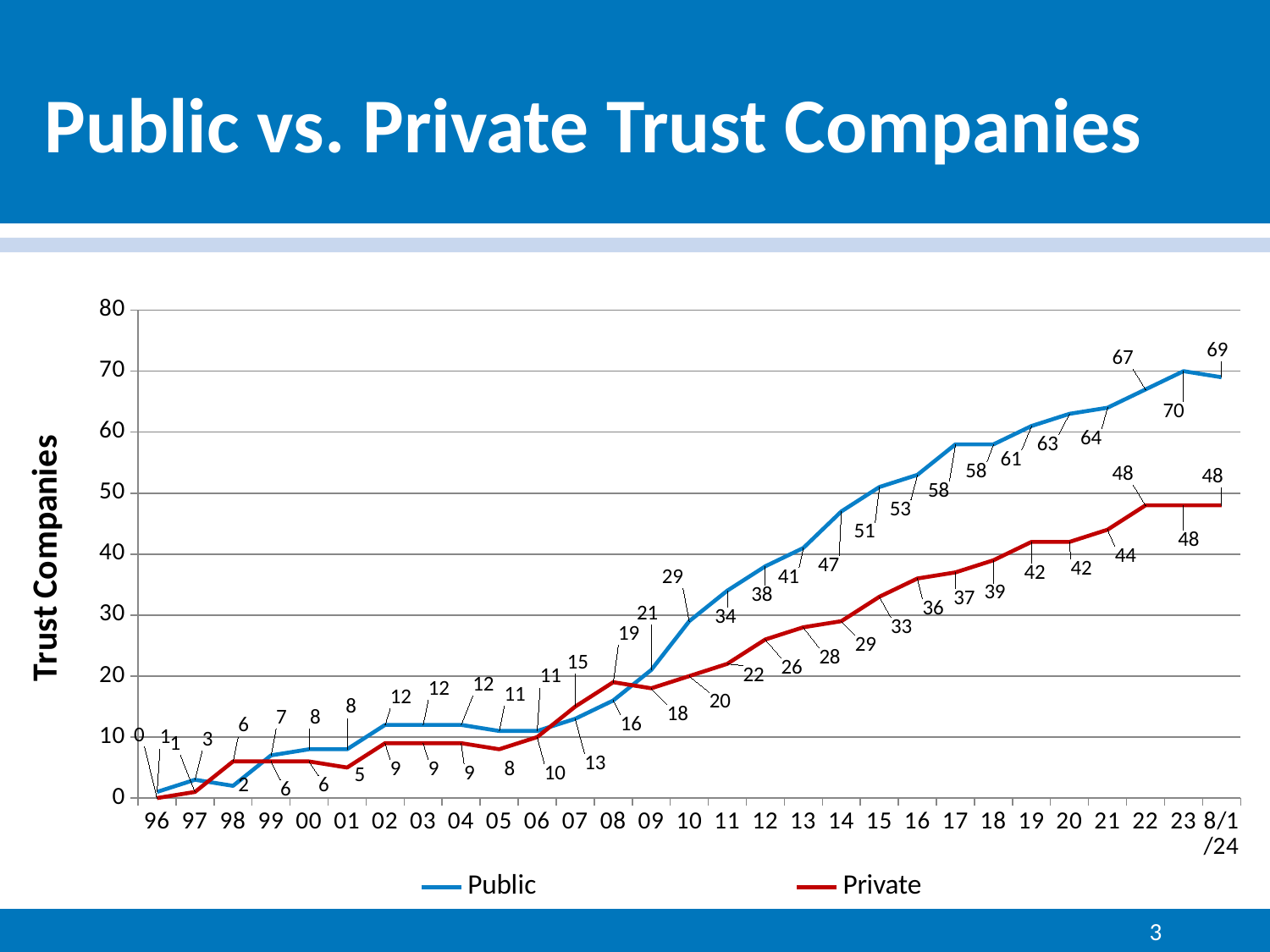
How many series does the legend list? 2 What is the value for Public in 10? 29 What is the value for Private in 15? 33 Does the Public series generally rise or fall from 96 to 23? rise Which is larger in 17, Public or Private? Public What is the y-axis title of the chart? Trust Companies In which year does the Public series reach its highest value? 23 What is the value for Public in 23? 70 How many points are plotted along the x axis for each series? 29 What type of chart is shown on the slide? line chart What is the difference between Public and Private in 8/1/24? 21 What is the value for Private in 8/1/24? 48